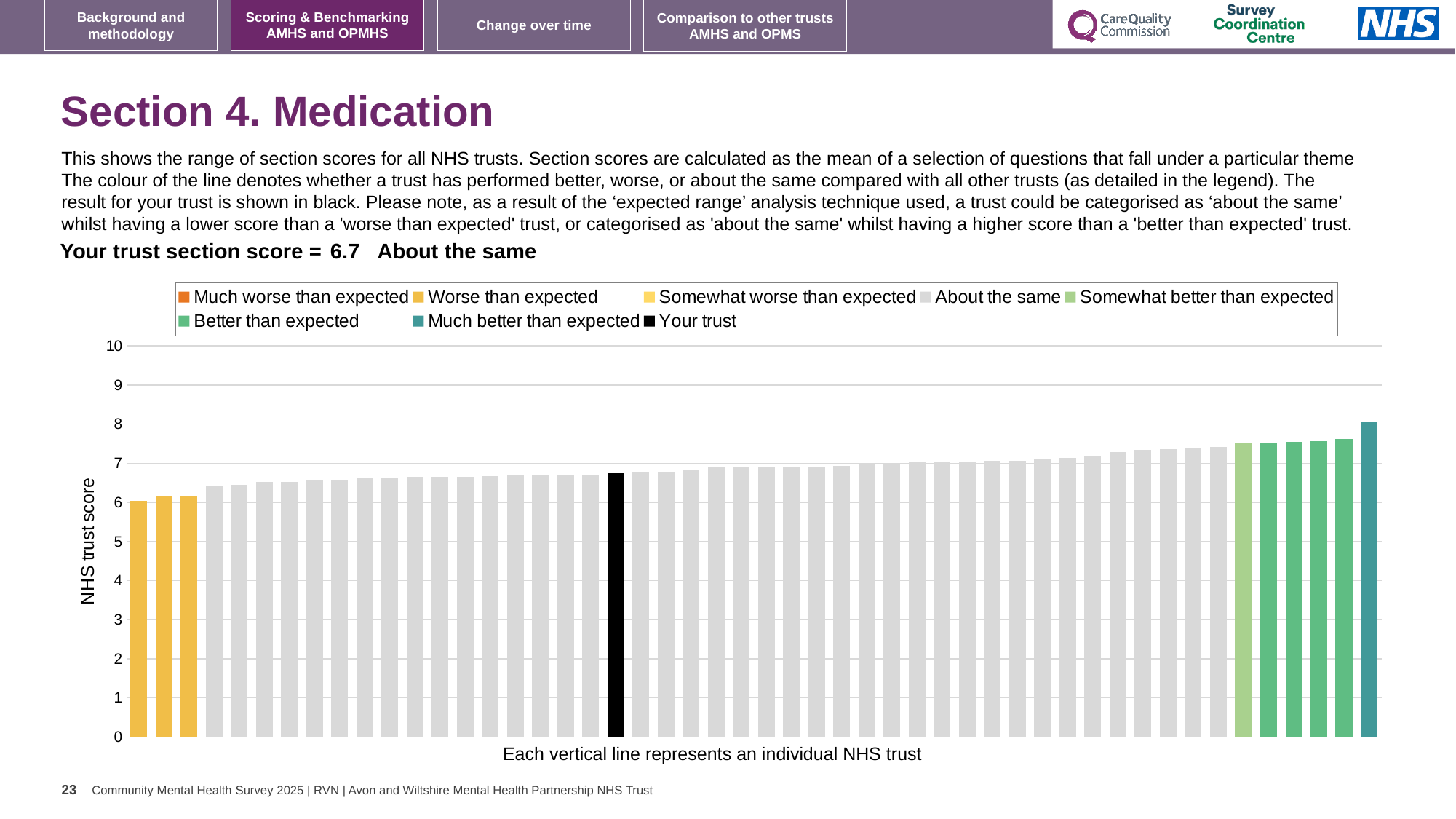
Is the value of the black 'Your trust' bar greater or less than 6? greater How many bars are shown in the 'Much better than expected' colour? 1 Is the value of the leftmost bar on the chart greater or less than 7? less What colour is the bar representing your trust? black What is the section score for your trust shown on the slide? 6.7 What is the label on the vertical axis of the chart? NHS trust score Is the value of the tallest bar on the chart greater or less than 7? greater Which legend category does the tallest bar on the chart belong to? Much better than expected What kind of chart is shown on the slide? bar chart How many entries does the chart legend list? 8 Which benchmarking category is your trust placed in for this section? About the same Do the bar values rise or fall moving from left to right along the x axis? rise